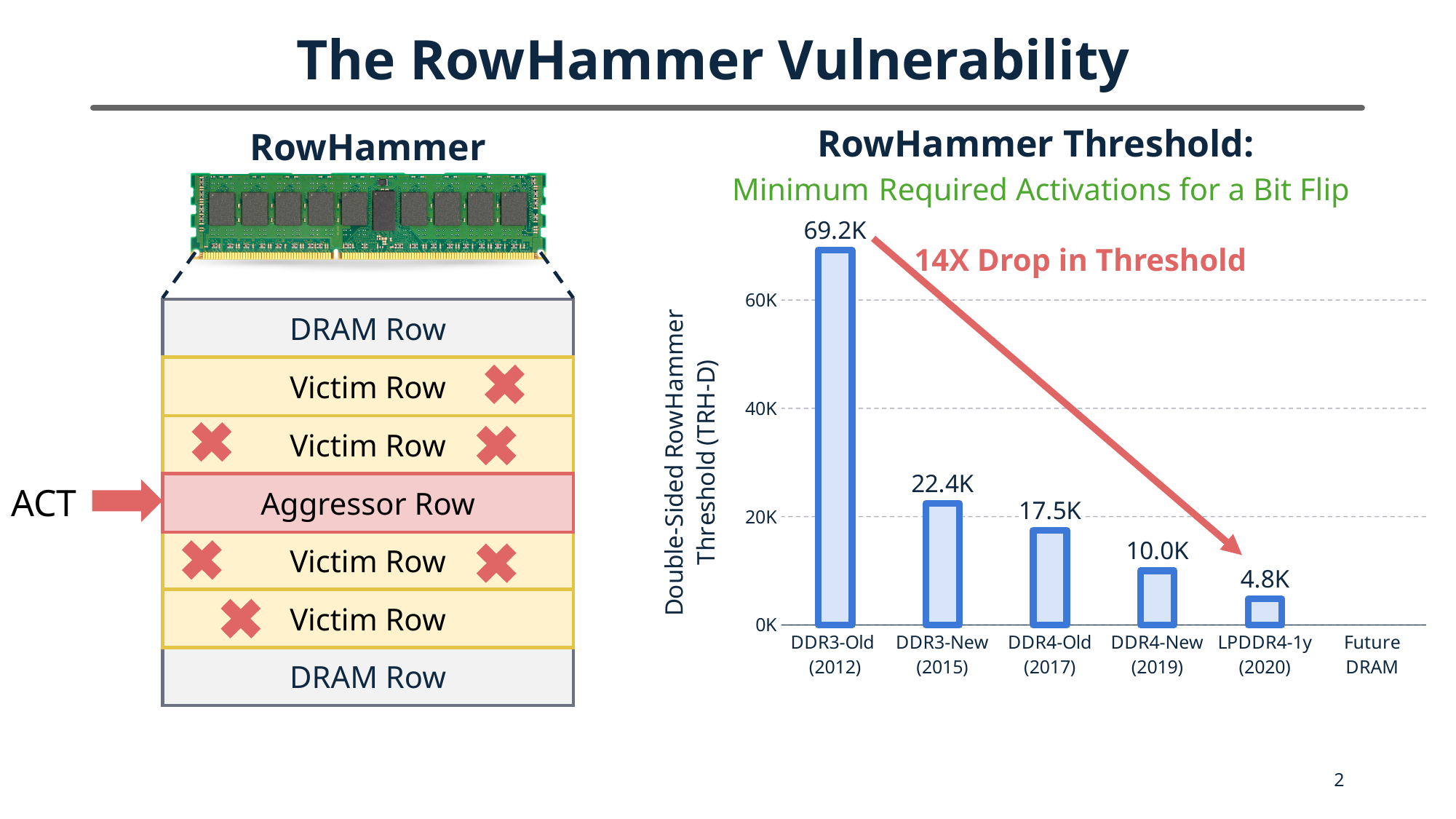
What is the RowHammer threshold value shown for DDR3-Old (2012)? 69.2K Which has a larger threshold, DDR3-New (2015) or DDR4-Old (2017)? DDR3-New (2015) How many bars are plotted in the chart? 5 What kind of chart is used to show the RowHammer threshold? Bar chart Do the threshold values rise or fall from left to right across the DRAM generations? Fall What is the value shown for DDR4-New (2019)? 10.0K What is the value shown for LPDDR4-1y (2020)? 4.8K What is the value shown for DDR4-Old (2017)? 17.5K What is the difference between the thresholds of DDR3-Old (2012) and DDR3-New (2015)? 46.8K Which DRAM generation has the highest RowHammer threshold? DDR3-Old (2012) Which DRAM generation with a plotted bar has the lowest RowHammer threshold? LPDDR4-1y (2020) What is the difference between the thresholds of DDR4-Old (2017) and DDR4-New (2019)? 7.5K